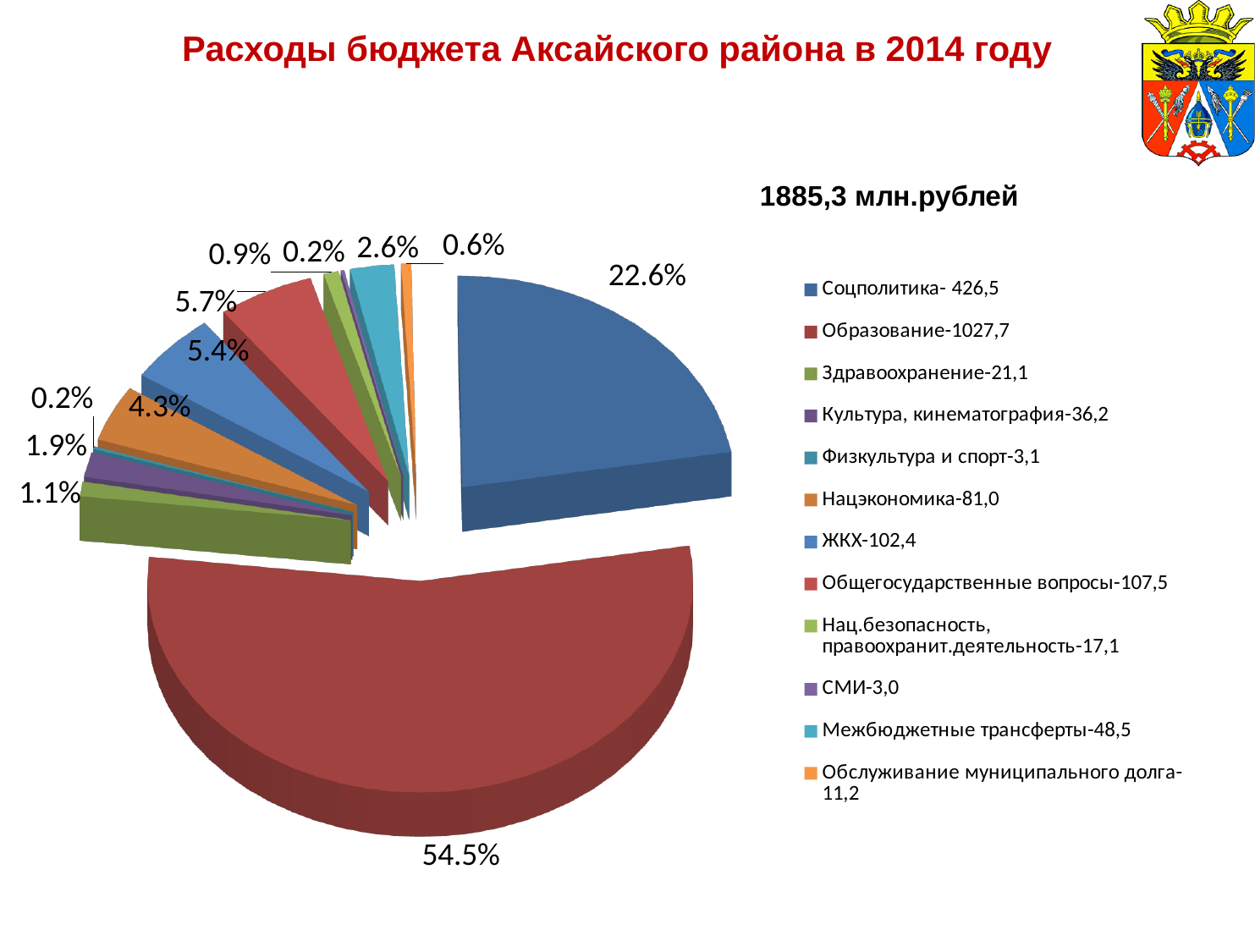
What total amount of budget expenditure is stated on the slide? 1885,3 млн.рублей What percentage share is shown for Соцполитика? 22.6% What value does the legend give for ЖКХ? 102,4 Which is larger: the share for Общегосударственные вопросы or the share for ЖКХ? Общегосударственные вопросы Which category has the largest share of the pie? Образование How many slices does the pie chart have? 12 What is the title of the slide? Расходы бюджета Аксайского района в 2014 году What percentage share is shown for Образование? 54.5% What kind of chart is shown on the slide? pie chart What value does the legend give for Нацэкономика? 81,0 What value does the legend give for Межбюджетные трансферты? 48,5 What is the difference in percentage points between the Образование share (54.5%) and the Соцполитика share (22.6%)? 31.9